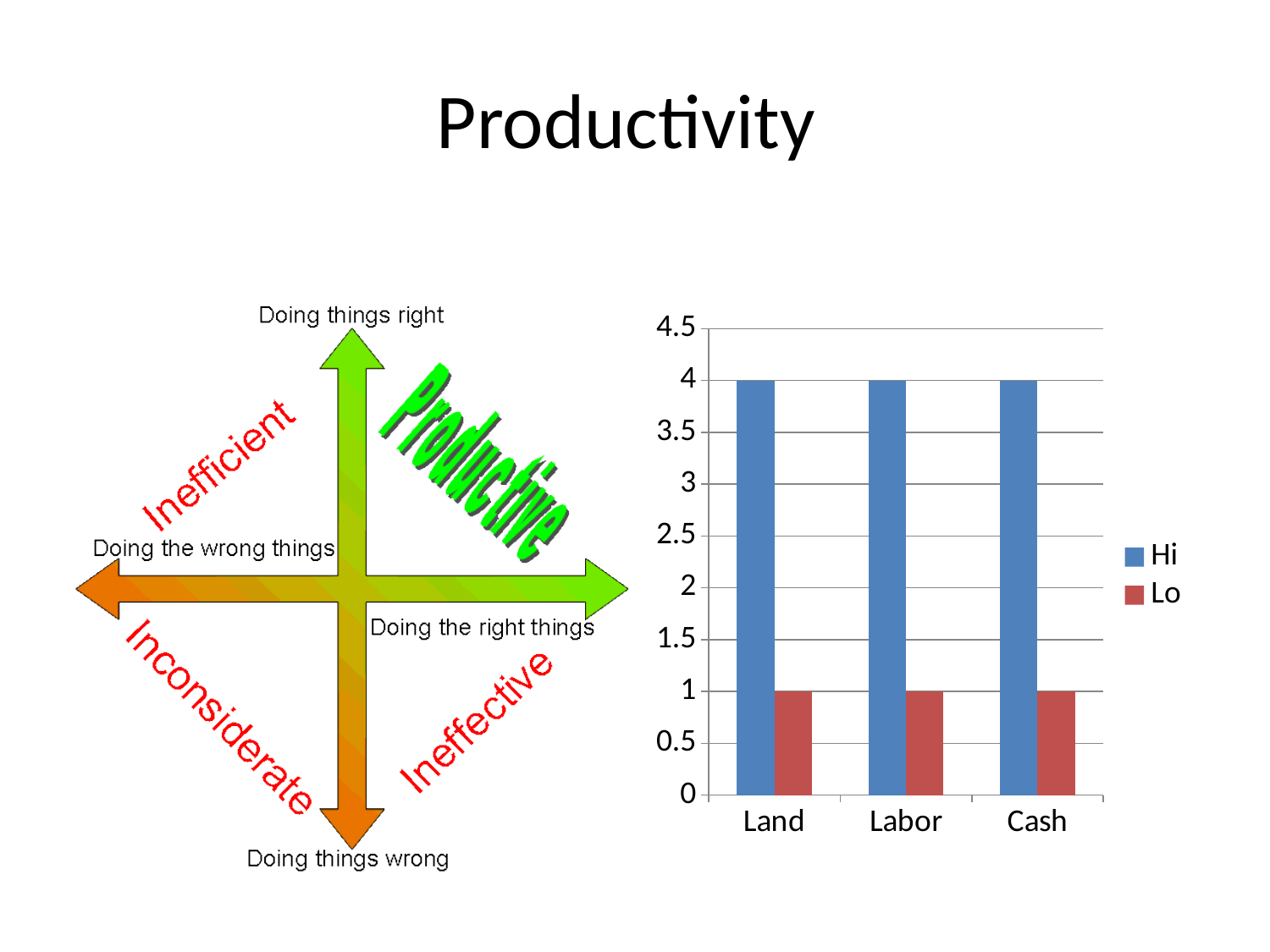
What is the Lo value for Labor in the bar chart? 1 Is the Hi value for Labor in the bar chart greater or less than 3? greater What is the Lo value for Cash in the bar chart? 1 How many series does the legend of the bar chart list? 2 What is the difference between the Hi and Lo values for Land in the bar chart? 3 What colour are the Hi bars in the bar chart? blue In the bar chart, which is larger for Labor, Hi or Lo? Hi What type of chart is shown on the right of the slide? bar chart How many categories are shown on the x axis of the bar chart? 3 Is the Lo value for Land in the bar chart greater or less than 2? less What is the Hi value for Land in the bar chart? 4 What is the Hi value for Cash in the bar chart? 4